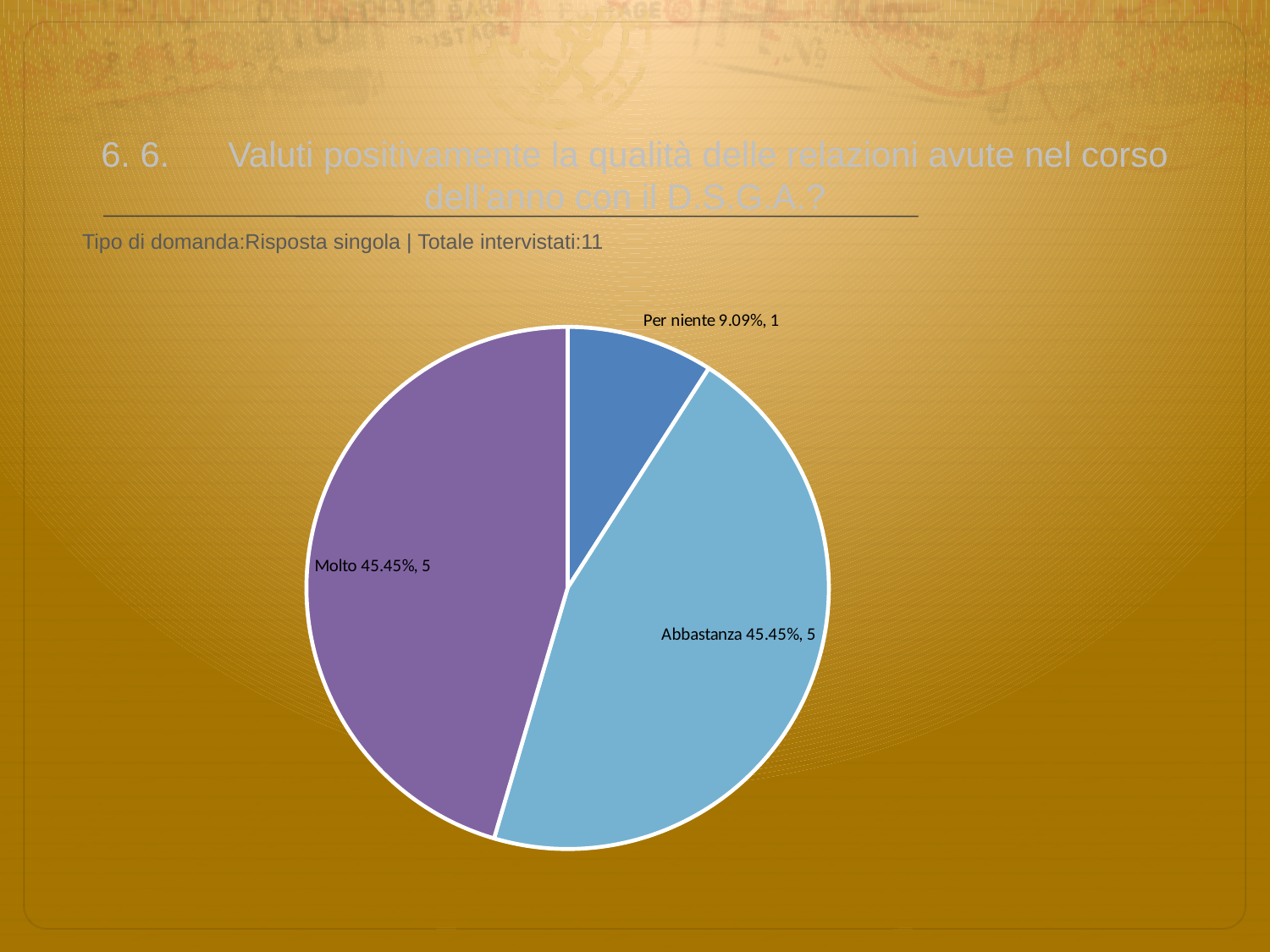
How many respondents chose "Abbastanza"? 5 How many respondents chose "Molto"? 5 What is the total number of respondents (Totale intervistati) shown on the slide? 11 What percentage share does the "Per niente" slice represent? 9.09% How many slices does the pie chart have? 3 What is the difference in number of respondents between "Abbastanza" and "Per niente"? 4 Which category has the smallest slice of the pie? Per niente What kind of chart is shown on the slide? pie chart How many respondents chose "Per niente"? 1 Which has more respondents, "Molto" or "Per niente"? Molto What percentage share does the "Molto" slice represent? 45.45% What colour is the "Molto" slice of the pie? purple